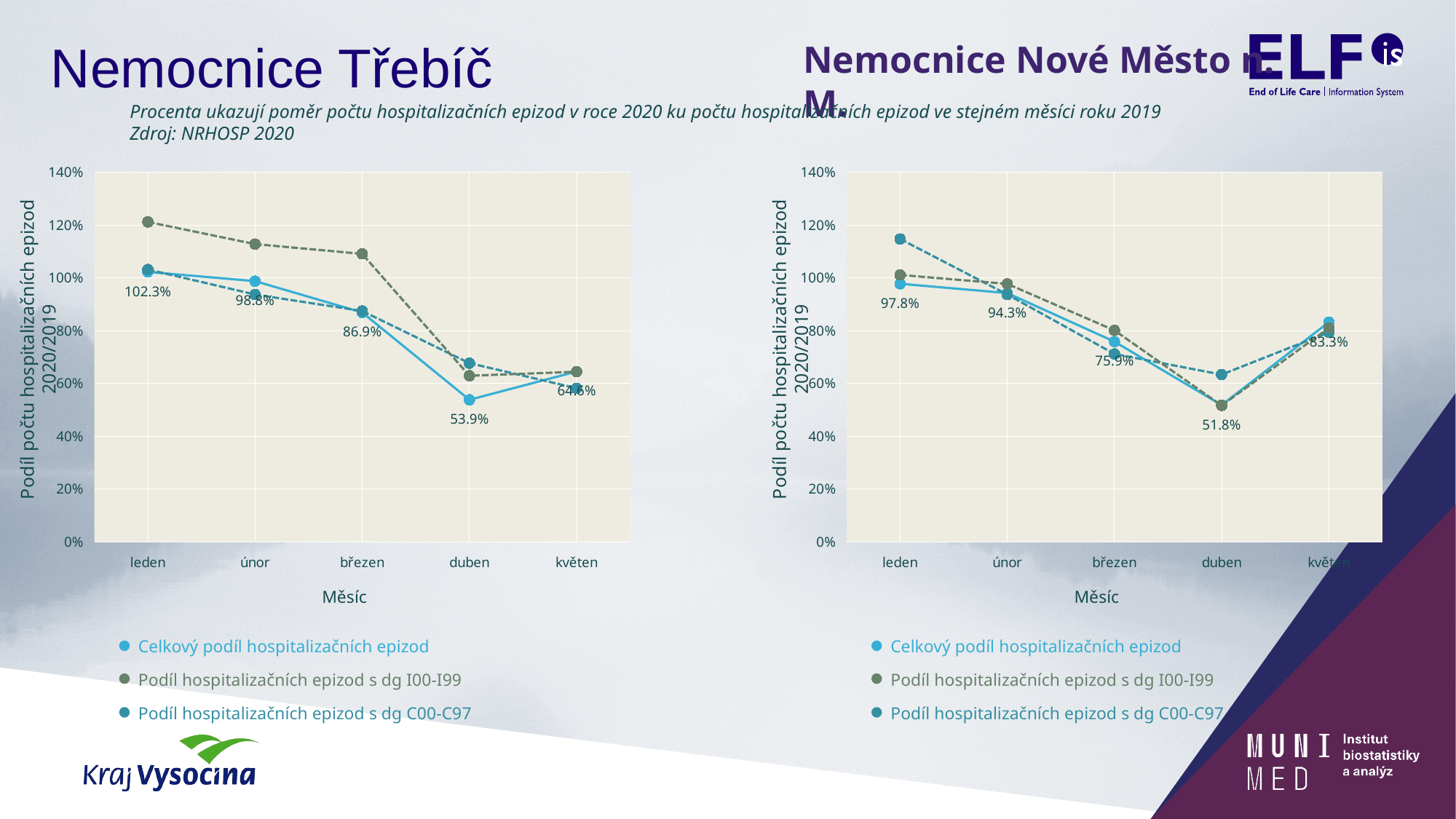
On the Nemocnice Nové Město n. M. chart, in which month is Celkový podíl hospitalizačních epizod highest? leden How many series does the legend of the Nemocnice Třebíč chart list? 3 On the Nemocnice Nové Město n. M. chart, what is the value of Celkový podíl hospitalizačních epizod for květen? 83.3% On the Nemocnice Třebíč chart, what is the difference between the Celkový podíl hospitalizačních epizod values for leden and únor? 3.5% What kind of chart is the Nemocnice Nové Město n. M. chart? line chart Which is larger: the Celkový podíl hospitalizačních epizod value for duben on the Nemocnice Třebíč chart or on the Nemocnice Nové Město n. M. chart? Nemocnice Třebíč On the Nemocnice Nové Město n. M. chart, what is the value of Celkový podíl hospitalizačních epizod for březen? 75.9% On the Nemocnice Třebíč chart, what is the value of Celkový podíl hospitalizačních epizod for duben? 53.9% How many months are shown on the x axis of the Nemocnice Nové Město n. M. chart? 5 On the Nemocnice Třebíč chart, what is the value of Celkový podíl hospitalizačních epizod for leden? 102.3% On the Nemocnice Třebíč chart, in which month is Celkový podíl hospitalizačních epizod lowest? duben